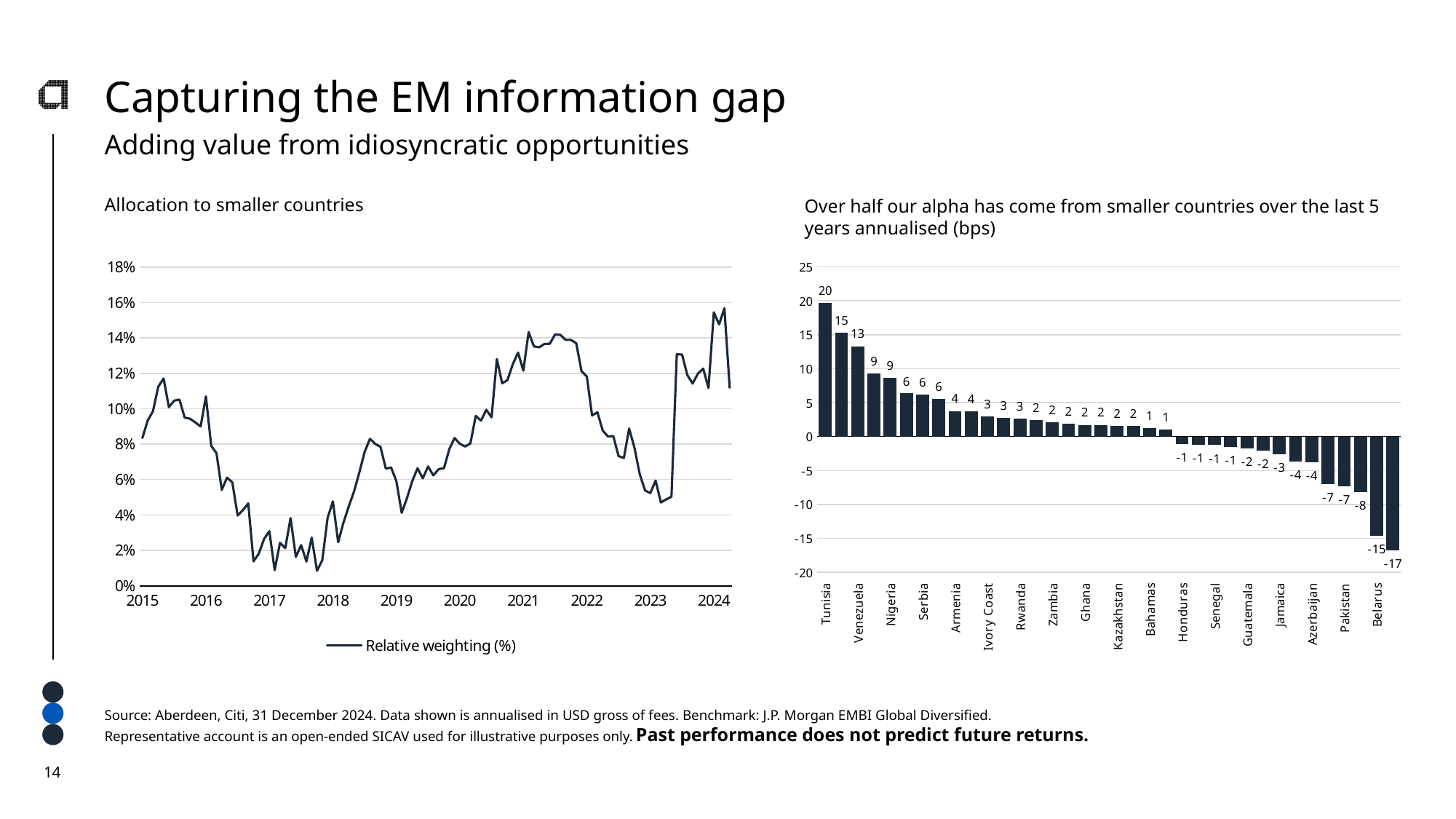
On the right-hand chart (alpha from smaller countries), what is the difference between the values for Tunisia and Belarus? 35 On the left-hand chart 'Allocation to smaller countries', is the relative weighting at the start of 2022 greater or less than 12%? greater On the right-hand chart (alpha from smaller countries), which country has the highest value? Tunisia How many series does the legend of the left-hand chart 'Allocation to smaller countries' list? 1 On the right-hand chart (alpha from smaller countries), what is the lowest value shown on any bar? -17 On the right-hand chart (alpha from smaller countries), what is the value for Belarus? -15 What kind of chart is the left-hand chart titled 'Allocation to smaller countries'? Line chart On the left-hand chart 'Allocation to smaller countries', is the relative weighting at the start of 2018 greater or less than 4%? less On the right-hand chart (alpha from smaller countries), which is larger, the value for Tunisia or the value for Venezuela? Tunisia On the right-hand chart (alpha from smaller countries), what is the value for Pakistan? -7 What kind of chart is the right-hand chart (alpha from smaller countries)? Bar chart On the right-hand chart (alpha from smaller countries), what is the value for Tunisia? 20